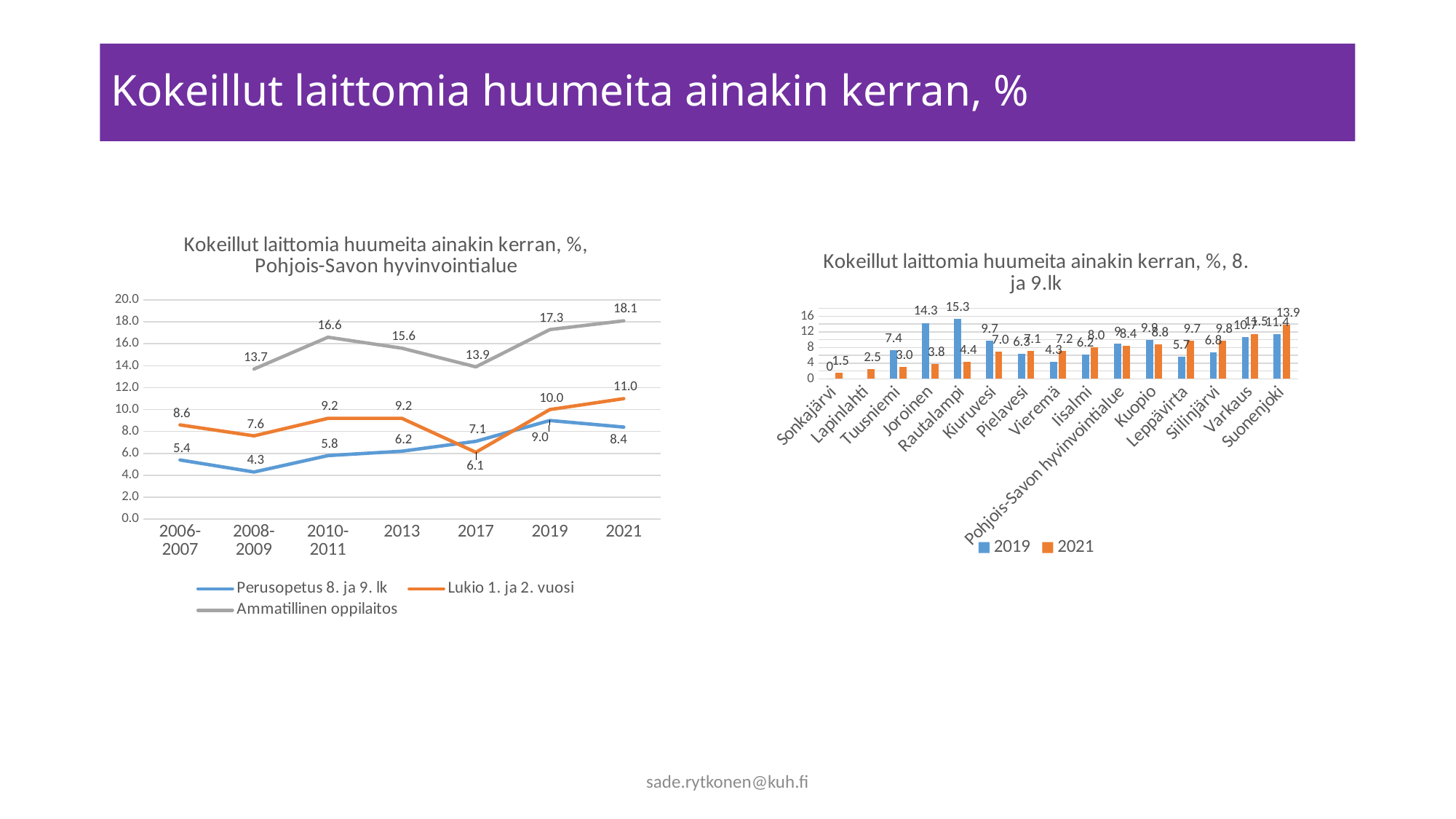
In the right chart (8. ja 9.lk), what is the difference between the 2019 and 2021 values for Joroinen? 10.5 In the right chart (8. ja 9.lk), what is the 2019 value for Rautalampi? 15.3 In the left chart (Pohjois-Savon hyvinvointialue), what is the difference between Ammatillinen oppilaitos and Lukio 1. ja 2. vuosi in 2019? 7.3 In the left chart (Pohjois-Savon hyvinvointialue), which is larger in 2017: Perusopetus 8. ja 9. lk or Lukio 1. ja 2. vuosi? Perusopetus 8. ja 9. lk In the right chart (8. ja 9.lk), what is the 2021 value for Suonenjoki? 13.9 In the left chart (Pohjois-Savon hyvinvointialue), in which year does the Lukio 1. ja 2. vuosi series reach its highest value? 2021 In the right chart (8. ja 9.lk), which municipality has the highest 2019 value? Rautalampi What kind of chart is the right chart (8. ja 9.lk)? Bar chart In the left chart (Pohjois-Savon hyvinvointialue), what is the value for Ammatillinen oppilaitos in 2021? 18.1 What kind of chart is the left chart (Pohjois-Savon hyvinvointialue)? Line chart How many series does the legend of the left chart (Pohjois-Savon hyvinvointialue) list? 3 In the left chart (Pohjois-Savon hyvinvointialue), what is the value for Perusopetus 8. ja 9. lk in 2008-2009? 4.3